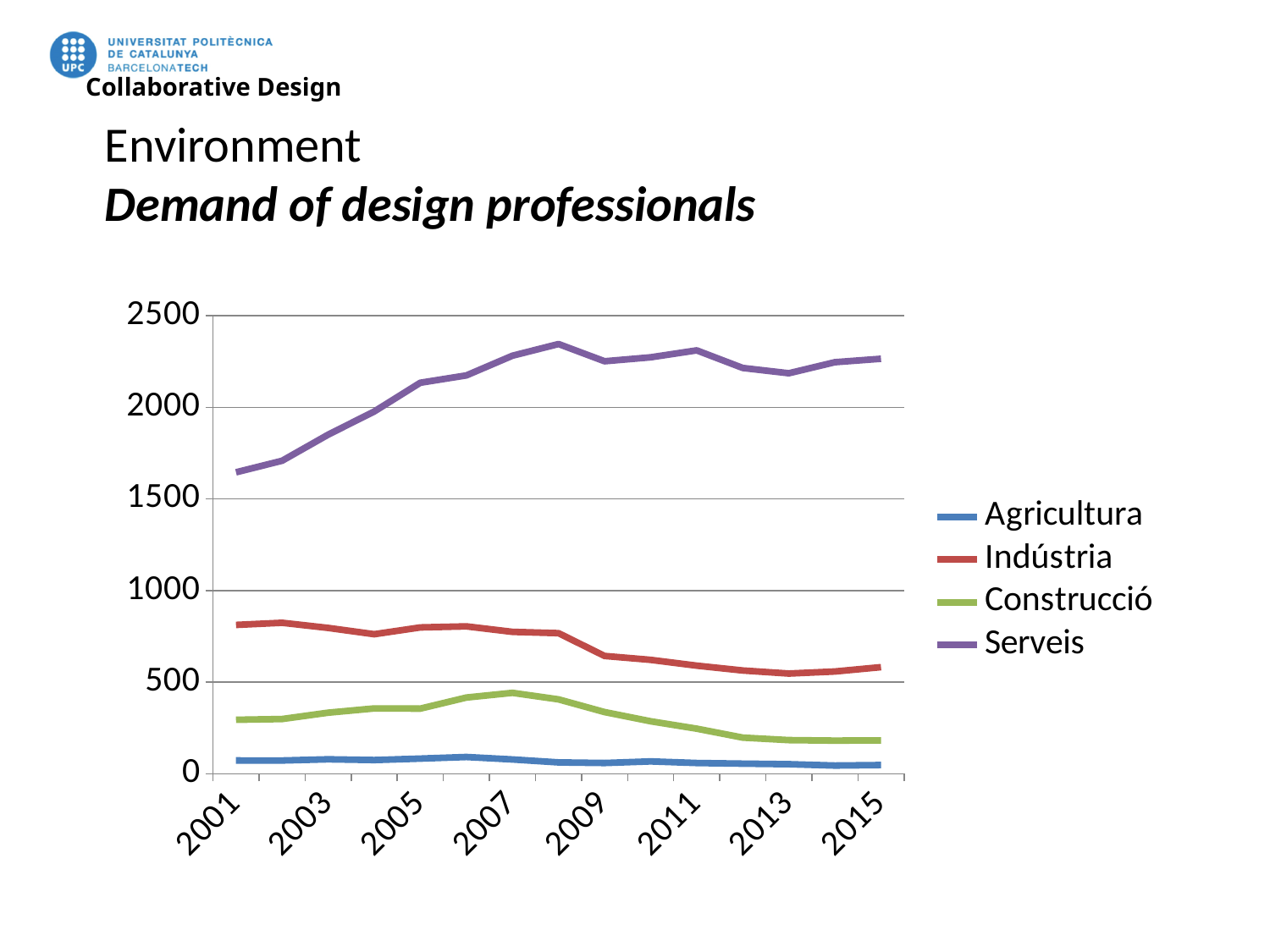
Which series has the lowest values throughout the chart? Agricultura Is the value for Serveis in 2001 greater or less than 1500? greater What is the title of the slide above the chart? Environment – Demand of design professionals Does the Construcció line rise or fall between 2007 and 2015? fall Is the value for Indústria in 2001 greater or less than 1000? less What kind of chart is shown on the slide? line chart How many series does the legend list? 4 In 2001, which is larger, the value for Indústria or the value for Construcció? Indústria Does the Serveis line rise or fall between 2001 and 2007? rise Is the value for Construcció in 2015 greater or less than 500? less Which series has the highest values throughout the chart? Serveis